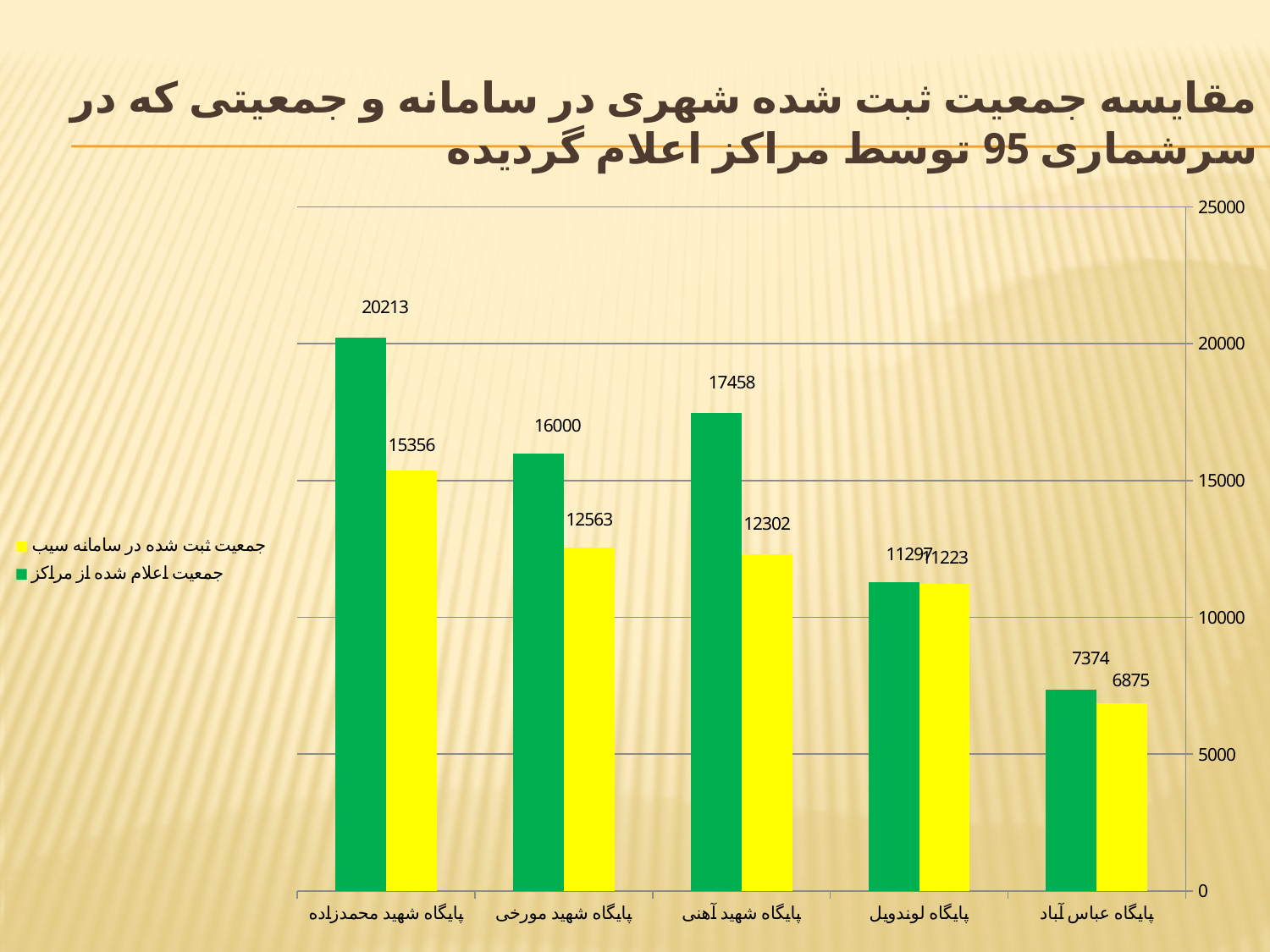
What is the value of جمعیت اعلام شده از مراکز for پایگاه شهید آهنی? 17458 What is the difference between جمعیت اعلام شده از مراکز and جمعیت ثبت شده در سامانه سیب for پایگاه شهید محمدزاده? 4857 Which category has the highest value for جمعیت اعلام شده از مراکز? پایگاه شهید محمدزاده How many series does the legend list? 2 For پایگاه شهید مورخی, which is larger: جمعیت اعلام شده از مراکز or جمعیت ثبت شده در سامانه سیب? جمعیت اعلام شده از مراکز Which category has the lowest value for جمعیت ثبت شده در سامانه سیب? پایگاه عباس آباد What is the value of جمعیت ثبت شده در سامانه سیب for پایگاه شهید مورخی? 12563 What type of chart is shown on the slide? bar chart Which colour represents جمعیت ثبت شده در سامانه سیب in the chart? yellow What is the value of جمعیت اعلام شده از مراکز for پایگاه شهید محمدزاده? 20213 How many categories (پایگاه) are shown on the x axis? 5 What is the value of جمعیت ثبت شده در سامانه سیب for پایگاه عباس آباد? 6875